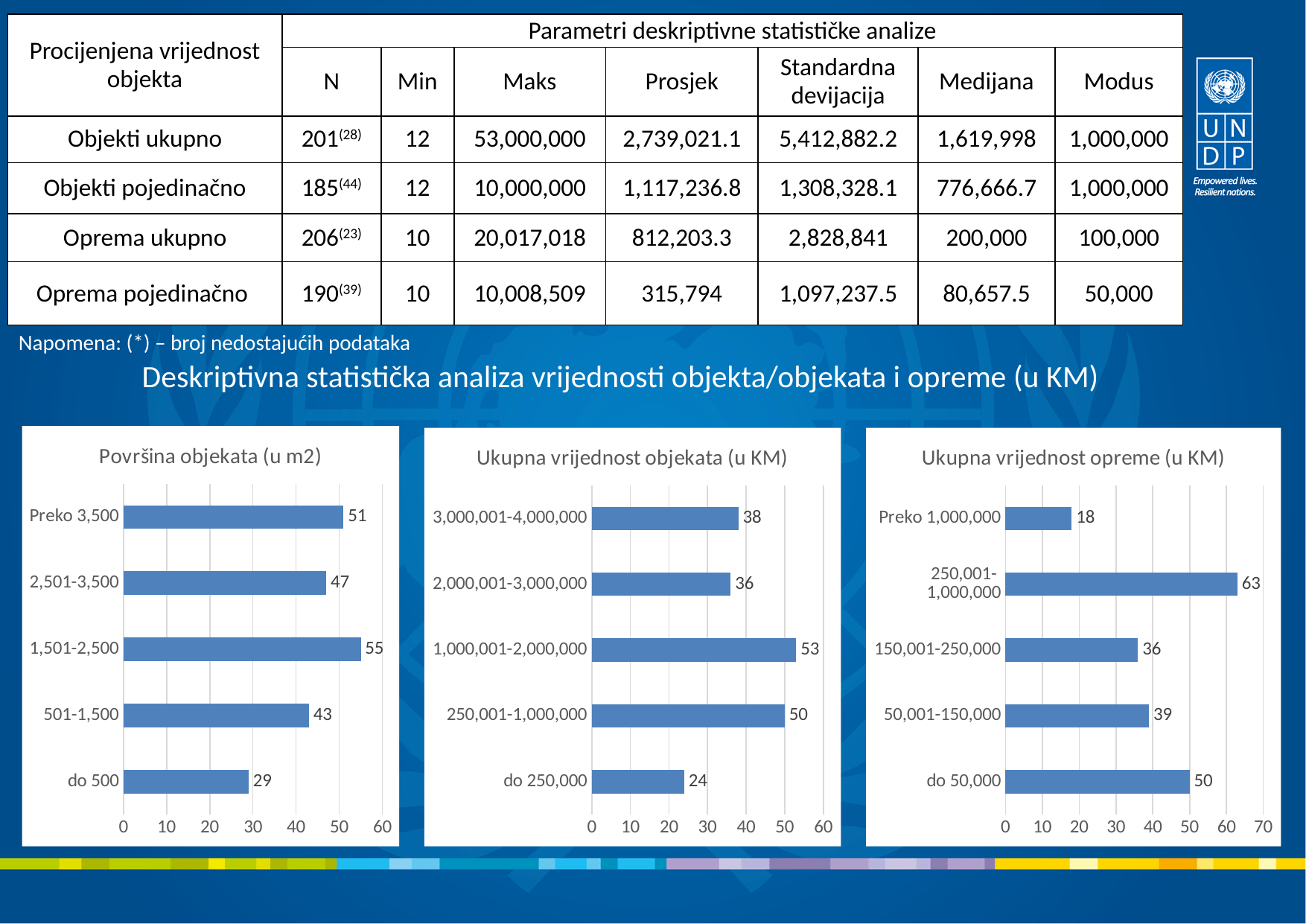
In the 'Ukupna vrijednost objekata (u KM)' chart, which category has the highest value? 1,000,001-2,000,000 In the 'Ukupna vrijednost opreme (u KM)' chart, which category has the highest value? 250,001-1,000,000 In the 'Ukupna vrijednost opreme (u KM)' chart, what is the value for 'Preko 1,000,000'? 18 How many categories are shown in the 'Ukupna vrijednost opreme (u KM)' chart? 5 In the 'Površina objekata (u m2)' chart, what is the value for '1,501-2,500'? 55 In the 'Ukupna vrijednost objekata (u KM)' chart, is the value for '2,000,001-3,000,000' greater or less than 30? greater In the 'Površina objekata (u m2)' chart, which category has the lowest value? do 500 In the 'Ukupna vrijednost opreme (u KM)' chart, what is the difference between the values for 'do 50,000' and '50,001-150,000'? 11 In the 'Površina objekata (u m2)' chart, what is the difference between the values for 'Preko 3,500' and '2,501-3,500'? 4 What type of chart is the 'Površina objekata (u m2)' chart? Bar chart In the 'Ukupna vrijednost objekata (u KM)' chart, which is larger: the value for '3,000,001-4,000,000' or for 'do 250,000'? 3,000,001-4,000,000 In the 'Ukupna vrijednost objekata (u KM)' chart, what is the value for '250,001-1,000,000'? 50